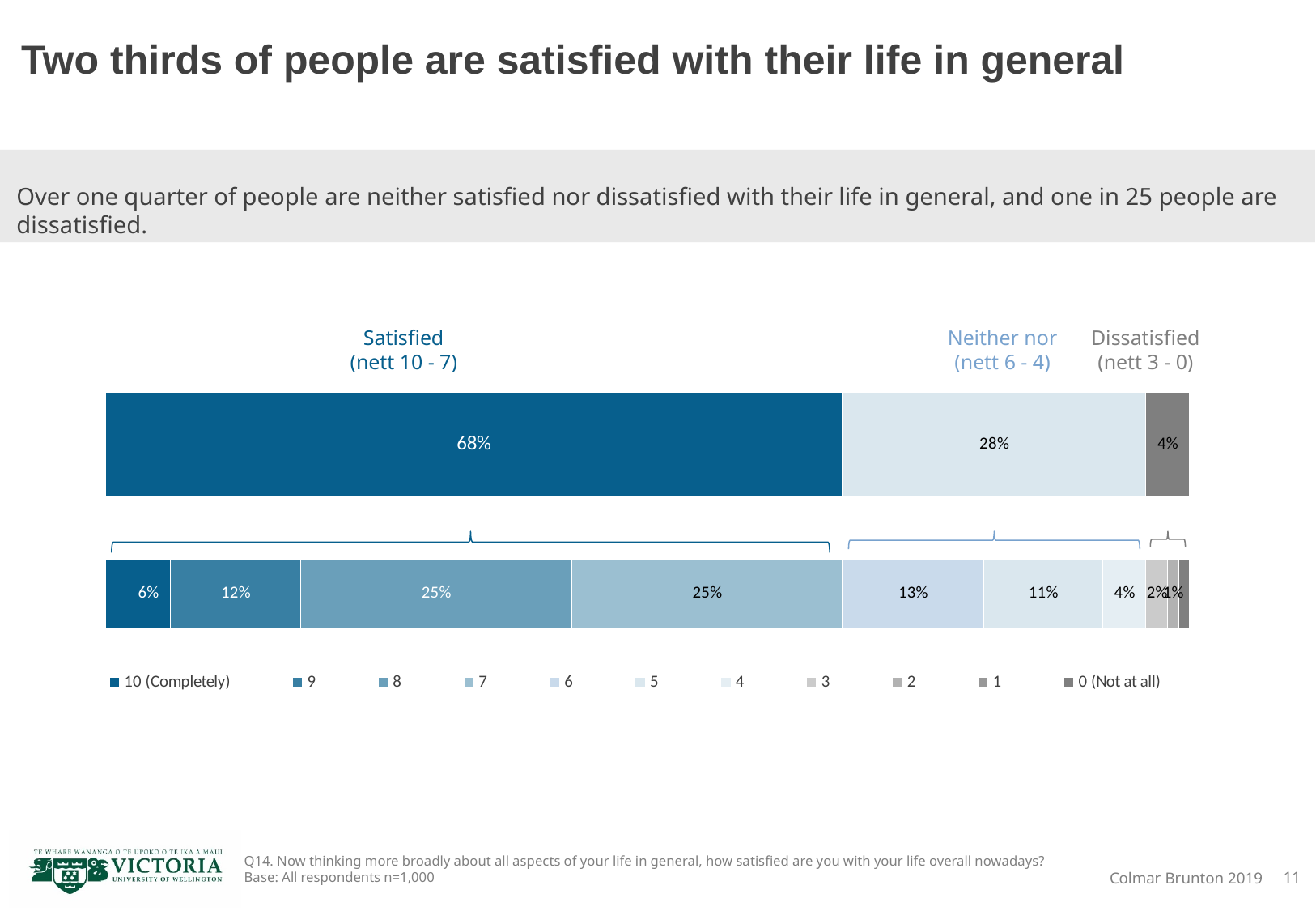
What percentage of people are neither satisfied nor dissatisfied (nett 6 - 4)? 28% What percentage of people gave a rating of 6? 13% Which is larger: the share of people rating 9 or the share rating 6? 6 What percentage of people gave a rating of 9? 12% What is the difference between the Satisfied (nett 10 - 7) share and the Neither nor (nett 6 - 4) share? 40 percentage points How many rating categories does the legend list? 11 What percentage of people are satisfied (nett 10 - 7) with their life in general? 68% What percentage of people are dissatisfied (nett 3 - 0)? 4% What percentage of people rated their life satisfaction as 10 (Completely)? 6% What kind of chart is shown on the slide? bar chart Which of the three nett groups (Satisfied, Neither nor, Dissatisfied) has the largest share? Satisfied (nett 10 - 7) What percentage of people gave a rating of 5? 11%